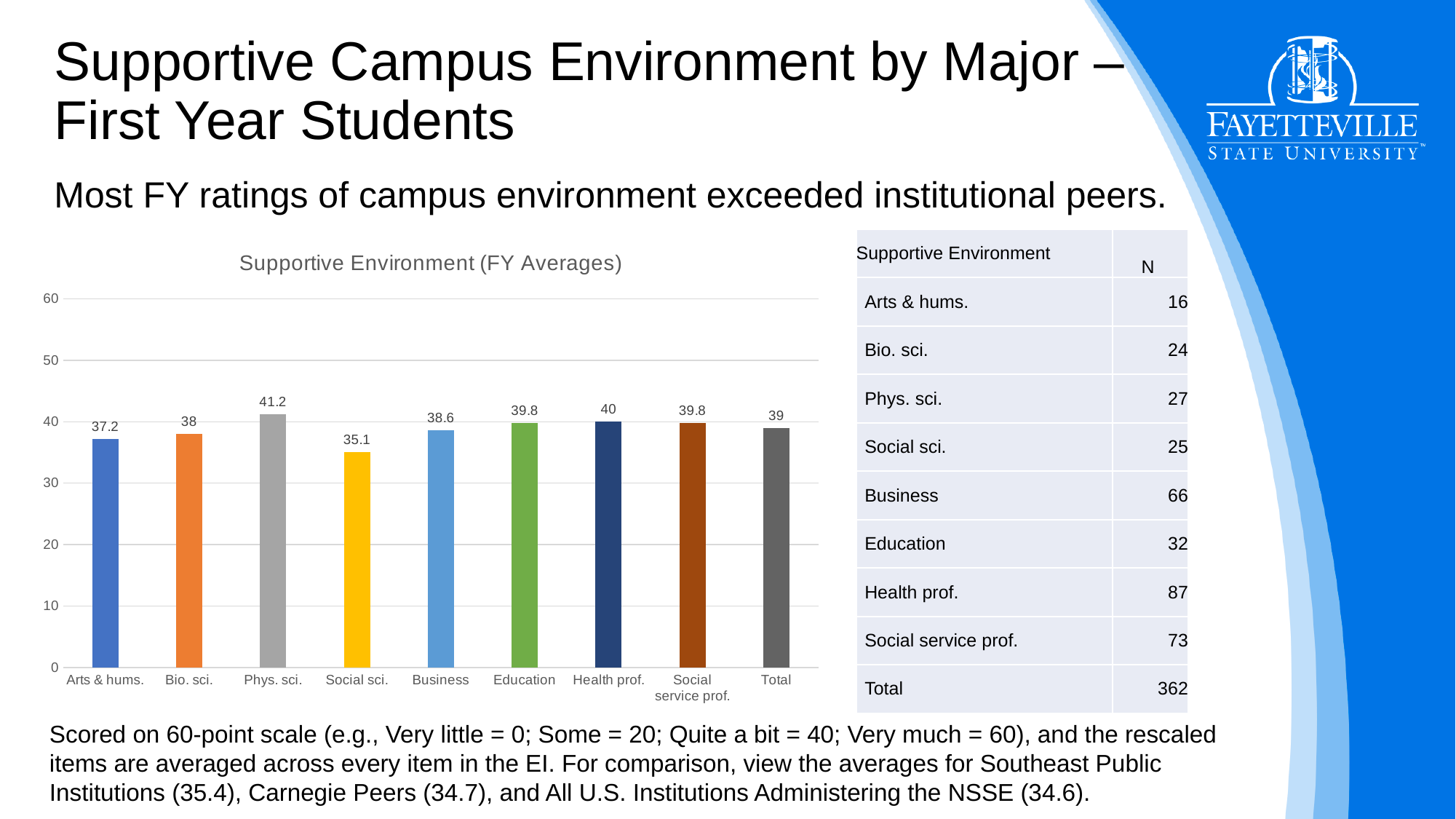
Is the value for Arts & hums. greater or less than 40? less What is the value for Phys. sci. in the Supportive Environment (FY Averages) chart? 41.2 Which is larger, the value for Bio. sci. or the value for Business? Business What is the value for Health prof. in the chart? 40 How many categories are shown on the x axis of the chart? 9 What is the title of the chart? Supportive Environment (FY Averages) Which category has the highest value in the chart? Phys. sci. What kind of chart is shown on the slide? bar chart What is the value for Social sci. in the chart? 35.1 What is the value for Total in the chart? 39 What is the difference between the values for Phys. sci. and Social sci.? 6.1 Which category has the lowest value in the chart? Social sci.